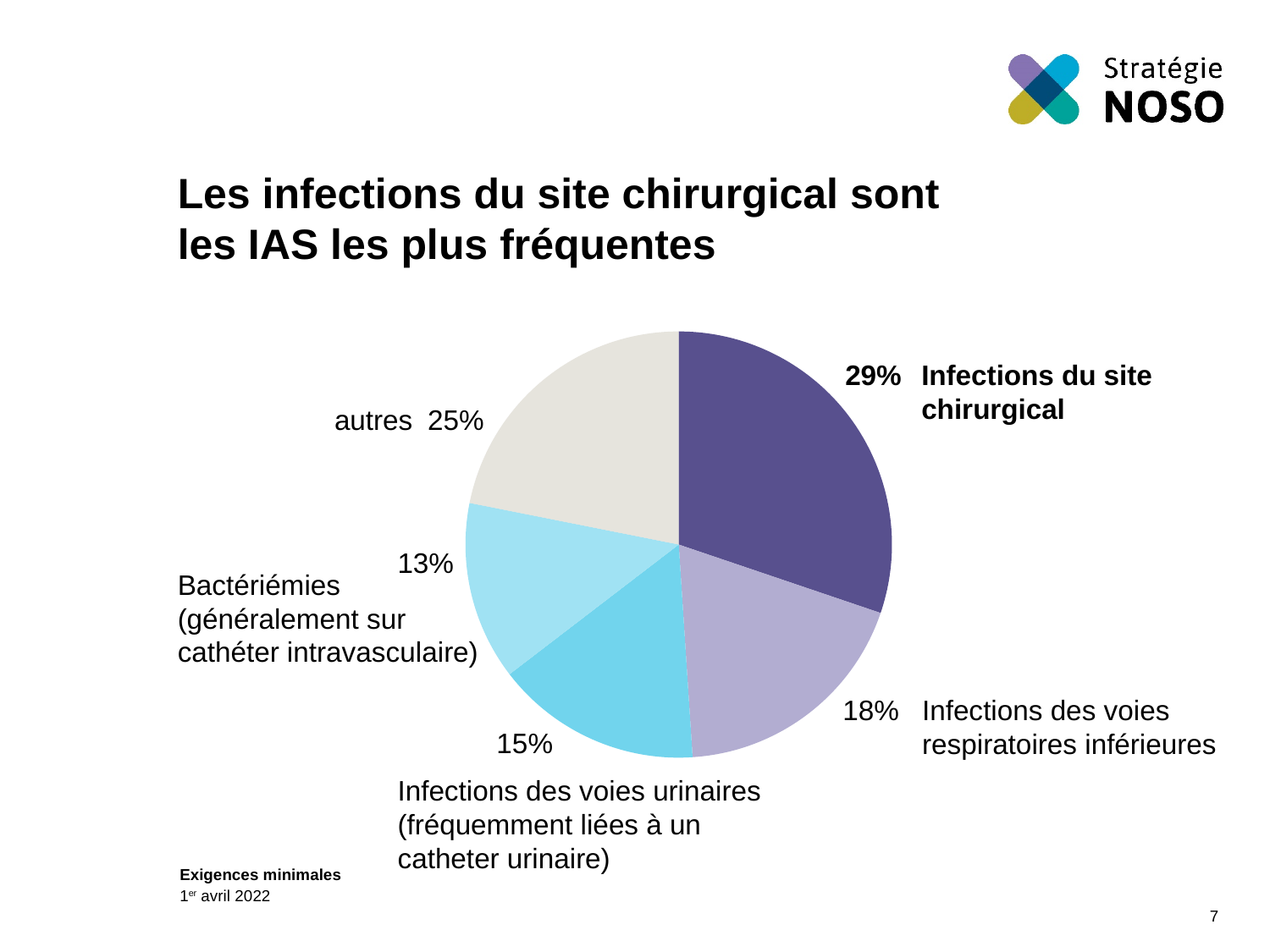
What percentage is shown for "Infections des voies urinaires"? 15% Which category has the largest share of the pie? Infections du site chirurgical Which is larger: the share for "Infections des voies respiratoires inférieures" or the share for "Infections des voies urinaires"? Infections des voies respiratoires inférieures What is the difference in percentage points between "Infections du site chirurgical" and "autres"? 4 What percentage is shown for "autres"? 25% What kind of chart is shown on the slide? pie chart What share of the pie is labelled "Infections du site chirurgical"? 29% Which category has the smallest share of the pie? Bactériémies What percentage is shown for "Bactériémies"? 13% What is the title of the slide containing the pie chart? Les infections du site chirurgical sont les IAS les plus fréquentes What percentage is shown for "Infections des voies respiratoires inférieures"? 18% How many slices does the pie chart have? 5